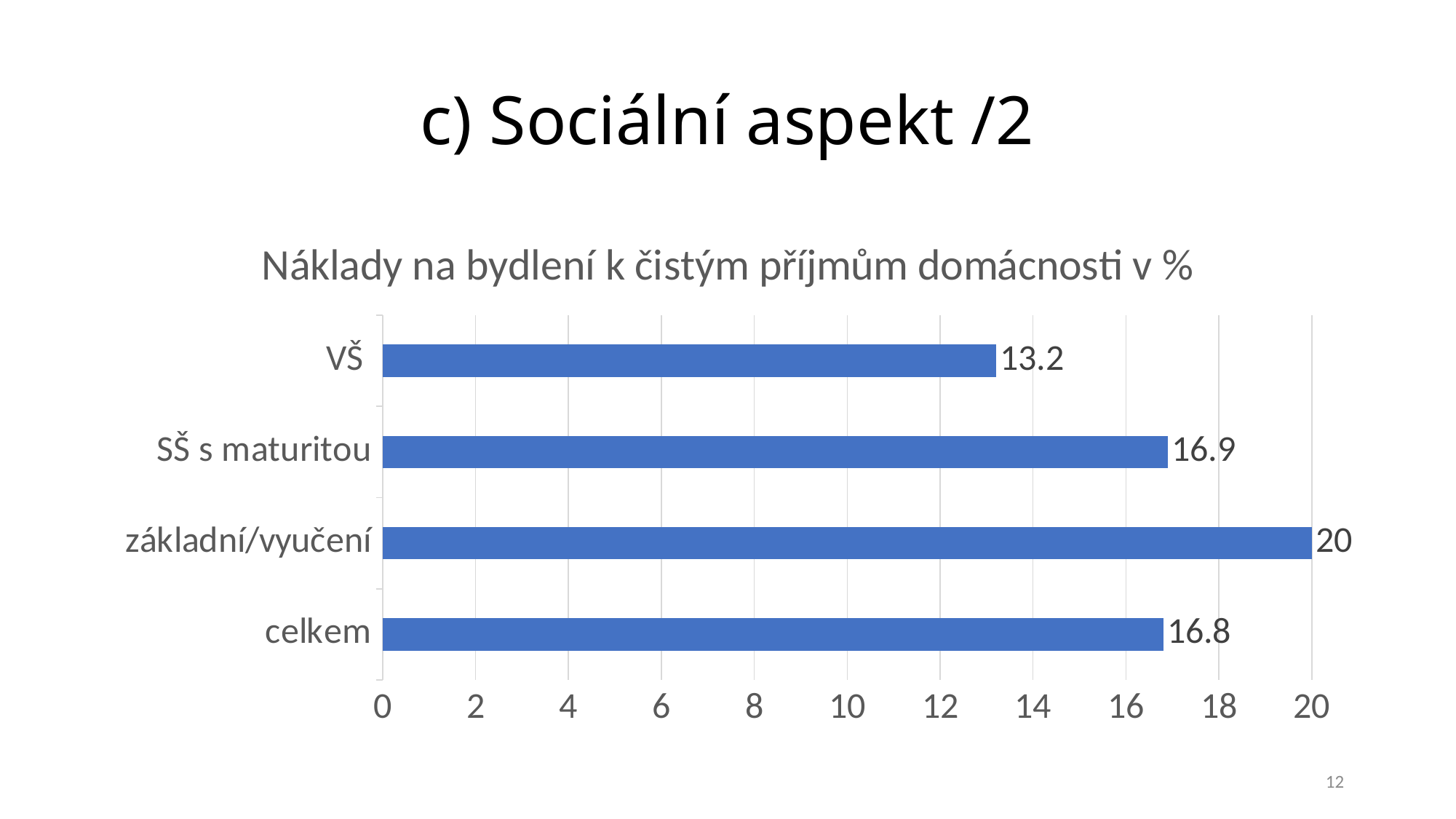
What is the difference between the values for SŠ s maturitou and celkem? 0.1 Which category has the highest value? základní/vyučení How many categories are shown in the chart? 4 What is the value for celkem? 16.8 What is the value for VŠ? 13.2 What kind of chart is shown on the slide? bar chart Which is larger, the value for SŠ s maturitou or the value for VŠ? SŠ s maturitou What is the value for základní/vyučení? 20 What is the value for SŠ s maturitou? 16.9 Which category has the lowest value? VŠ What is the difference between the values for základní/vyučení and VŠ? 6.8 What is the title of the chart? Náklady na bydlení k čistým příjmům domácnosti v %